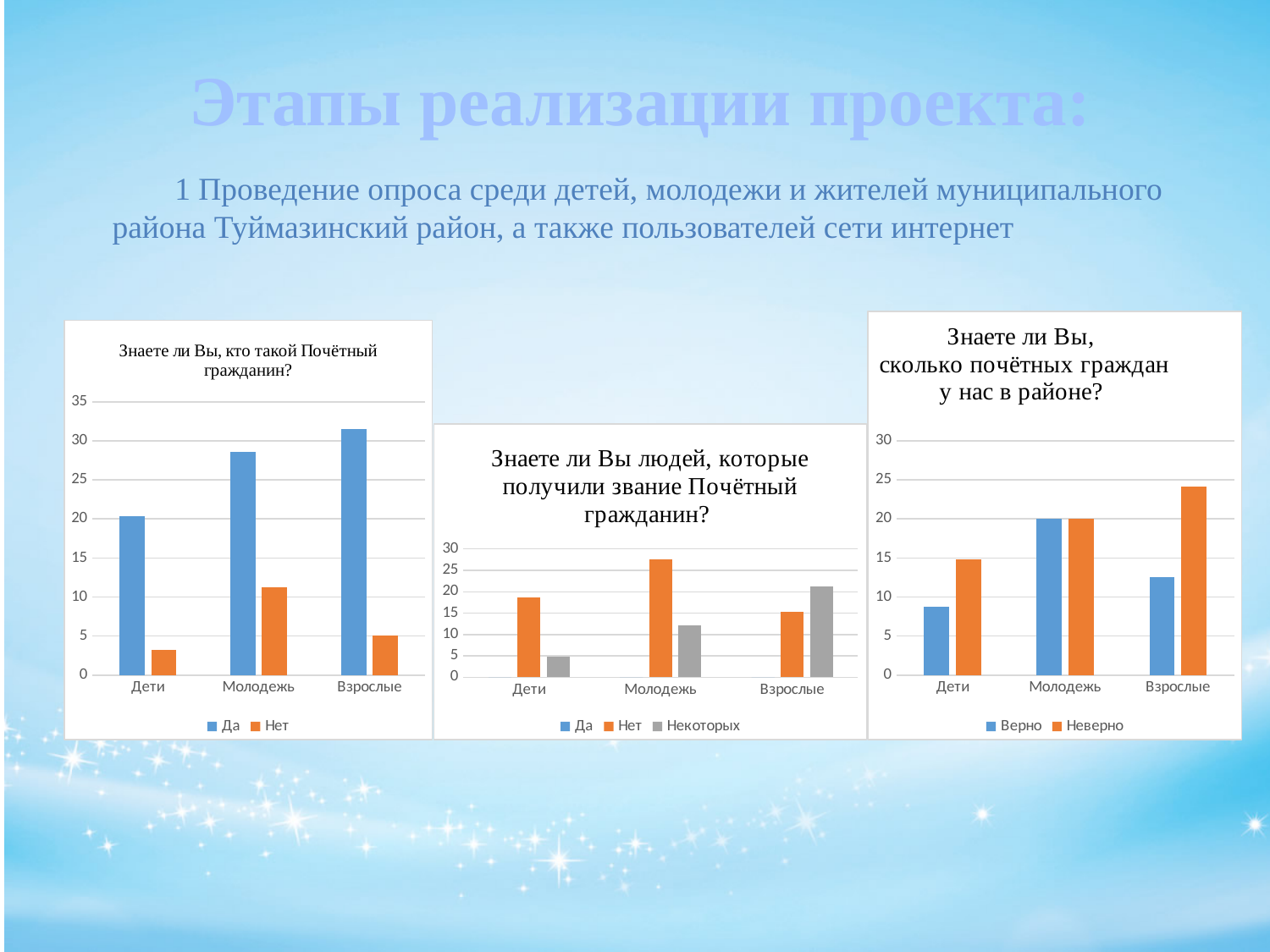
In the middle chart "Знаете ли Вы людей, которые получили звание Почётный гражданин?", how many series does the legend list? 3 In the left chart "Знаете ли Вы, кто такой Почётный гражданин?", do the "Да" values rise or fall from Дети to Взрослые? rise In the left chart "Знаете ли Вы, кто такой Почётный гражданин?", which is larger for Дети: "Да" or "Нет"? Да In the middle chart "Знаете ли Вы людей, которые получили звание Почётный гражданин?", which category has the lowest "Некоторых" value? Дети In the right chart "Знаете ли Вы, сколько почётных граждан у нас в районе?", how many categories are shown on the x axis? 3 In the left chart "Знаете ли Вы, кто такой Почётный гражданин?", which category has the highest value for "Да"? Взрослые In the right chart "Знаете ли Вы, сколько почётных граждан у нас в районе?", which is larger for Взрослые: "Верно" or "Неверно"? Неверно What kind of chart is the left chart titled "Знаете ли Вы, кто такой Почётный гражданин?"? bar chart In the middle chart "Знаете ли Вы людей, которые получили звание Почётный гражданин?", which category has the highest "Нет" value? Молодежь In the middle chart "Знаете ли Вы людей, которые получили звание Почётный гражданин?", is the "Некоторых" value for Взрослые greater or less than 15? greater In the left chart "Знаете ли Вы, кто такой Почётный гражданин?", is the "Нет" value for Молодежь greater or less than 10? greater In the right chart "Знаете ли Вы, сколько почётных граждан у нас в районе?", what is the "Верно" value for Молодежь? 20